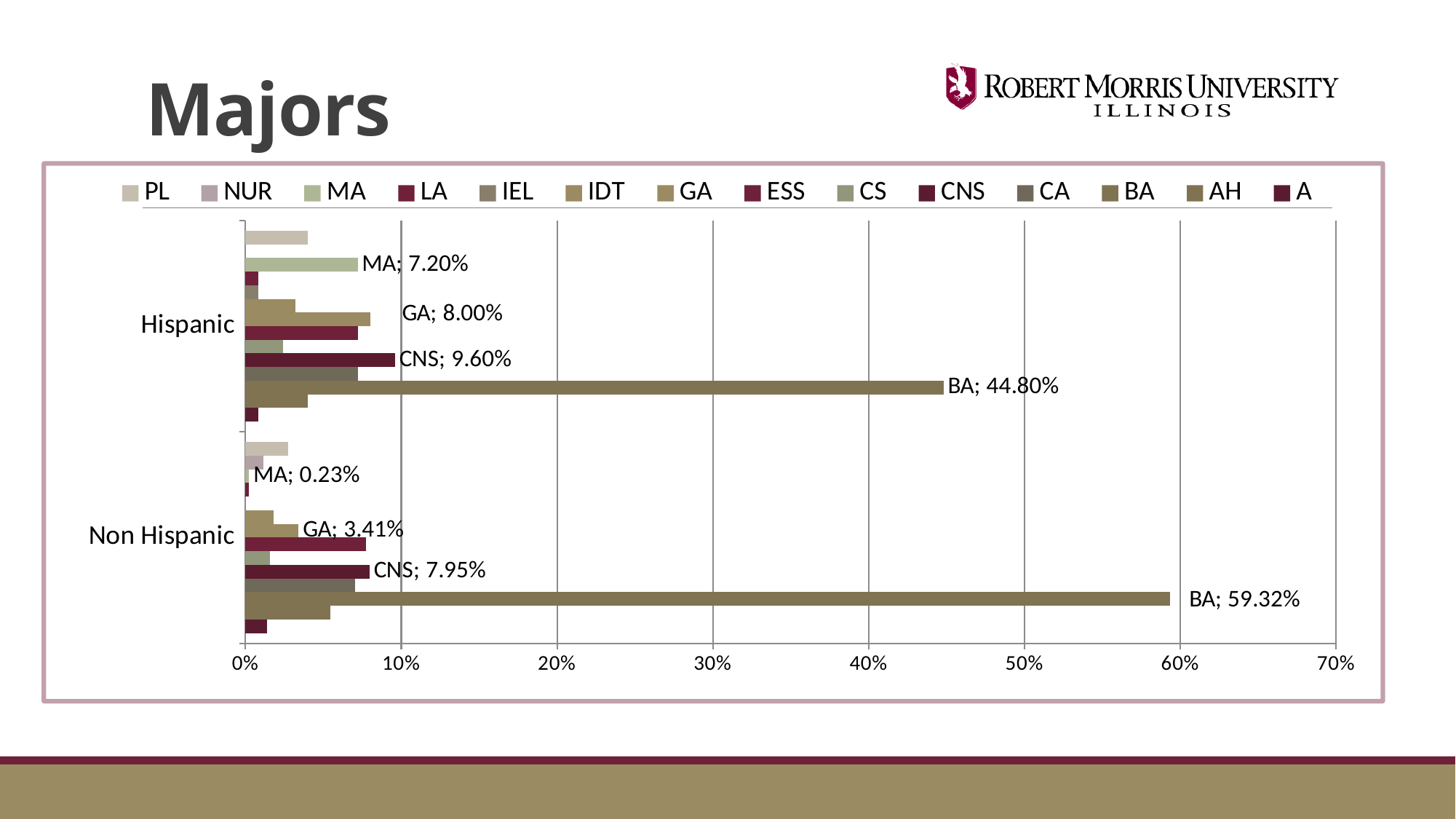
What is the value for GA in the Non Hispanic group? 3.41% What is the value for BA in the Hispanic group? 44.80% How many series does the legend list? 14 What kind of chart is shown on the slide? Bar chart Is the BA value for the Hispanic group greater or less than 40%? greater What is the difference between the BA values for the Non Hispanic and Hispanic groups? 14.52% What is the value for MA in the Non Hispanic group? 0.23% What is the value for BA in the Non Hispanic group? 59.32% How many groups are shown on the vertical axis? 2 Which is larger, the GA value for Hispanic or the GA value for Non Hispanic? Hispanic Which major has the highest value in the Non Hispanic group? BA What is the value for CNS in the Hispanic group? 9.60%